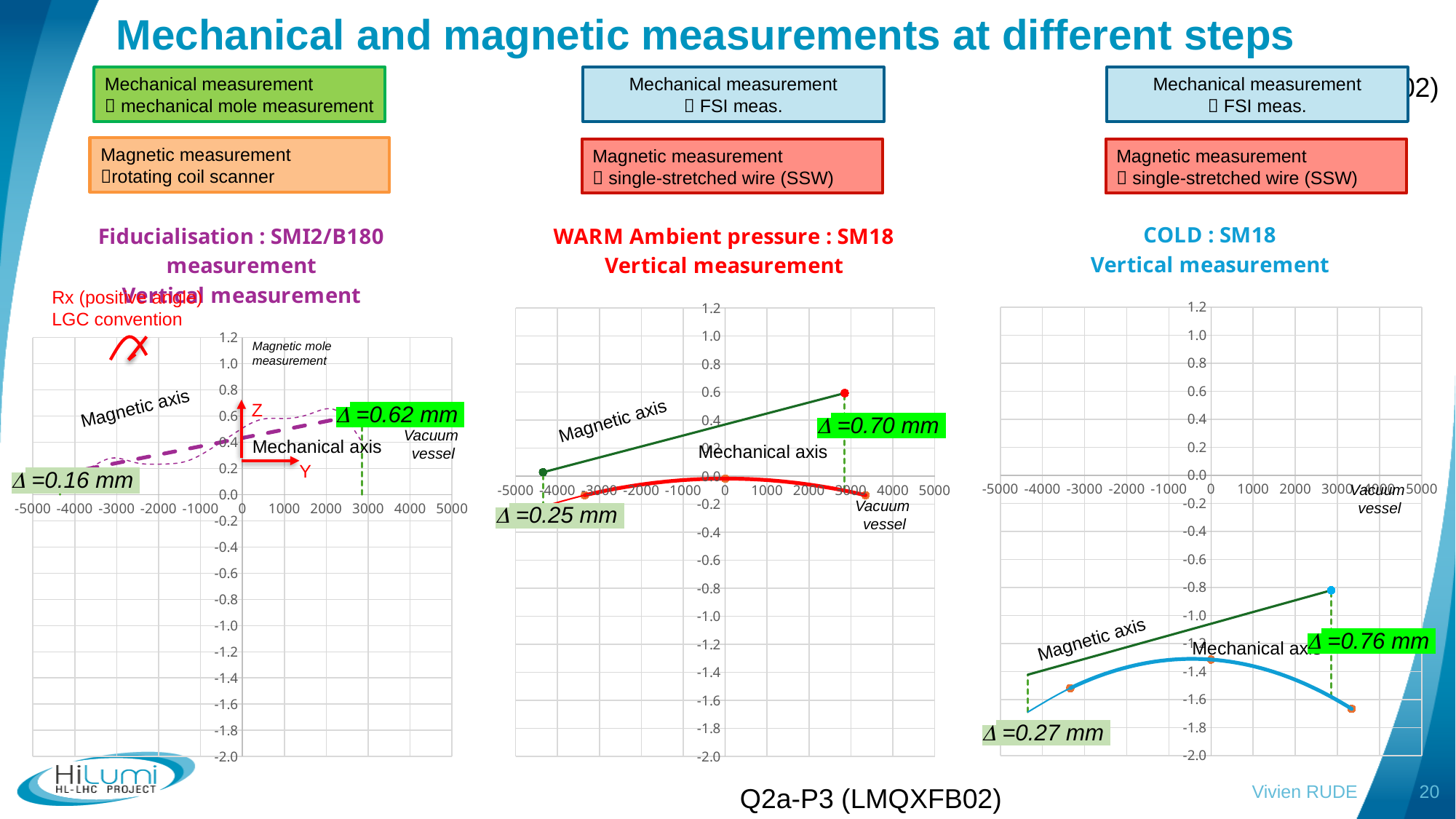
In the WARM Ambient pressure SM18 chart in the middle, what is the Δ value shown at the left end of the axes? 0.25 mm In the WARM Ambient pressure SM18 chart in the middle, is the magnetic axis value at x = 3000 greater or less than 0.4? greater In the Fiducialisation SMI2/B180 chart on the left, what is the Δ value shown at the right end of the axes? 0.62 mm In the Fiducialisation SMI2/B180 chart on the left, what is the Δ value shown at the left end of the axes? 0.16 mm In the COLD SM18 chart on the right, what is the difference between the two Δ values shown? 0.49 mm In the WARM Ambient pressure SM18 chart in the middle, what is the Δ value shown at the right end of the axes? 0.70 mm In the WARM Ambient pressure SM18 chart in the middle, what is the difference between the two Δ values shown? 0.45 mm Which chart shows the larger right-end Δ value, the WARM Ambient pressure SM18 chart or the COLD SM18 chart? COLD SM18 What is the highest tick value on the vertical axis of the COLD SM18 chart on the right? 1.2 In the COLD SM18 chart on the right, what is the Δ value shown at the left end of the axes? 0.27 mm In the COLD SM18 chart on the right, what is the Δ value shown at the right end of the axes? 0.76 mm In the COLD SM18 chart on the right, is the magnetic axis value at x = 3000 greater or less than -0.6? less